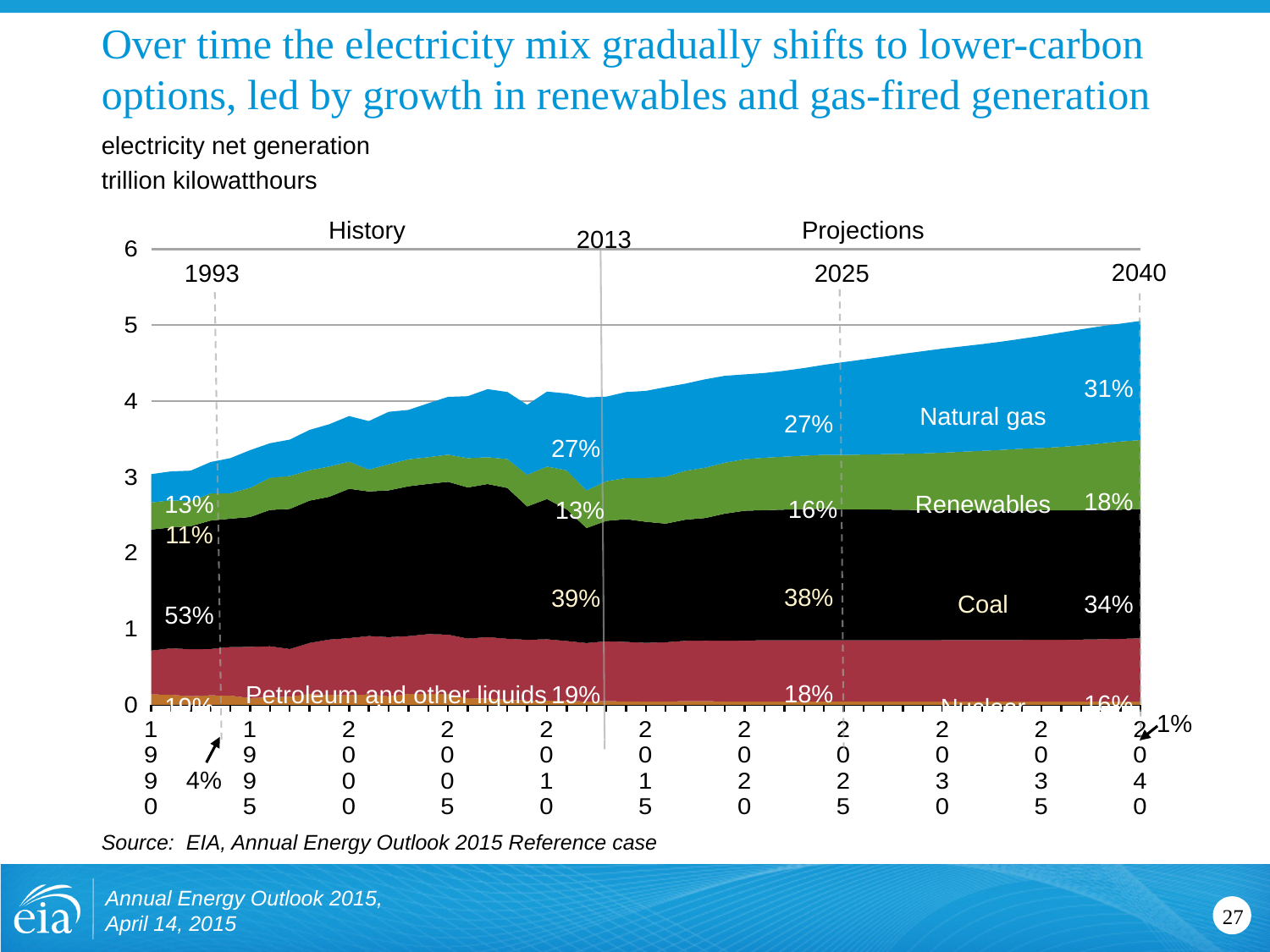
By how many percentage points does the renewables share rise between 2013 and 2040? 5 percentage points Which fuel has the largest share of electricity net generation in 2013? Coal What kind of chart is shown on the slide? Stacked area chart In 2040, which has the larger share of generation, natural gas or renewables? Natural gas What share of electricity net generation does natural gas account for in 2013? 27% By how many percentage points does coal's share fall between 1993 and 2040? 19 percentage points What share of electricity net generation do renewables account for in 2025? 16% What share of electricity net generation does coal account for in 2040? 34% What share of electricity net generation does coal account for in 1993? 53% Is total electricity net generation in 1993 greater or less than 4 trillion kilowatthours? less What share of electricity net generation do petroleum and other liquids account for in 2040? 1% Does the share of natural gas rise or fall from 1993 to 2040? Rises